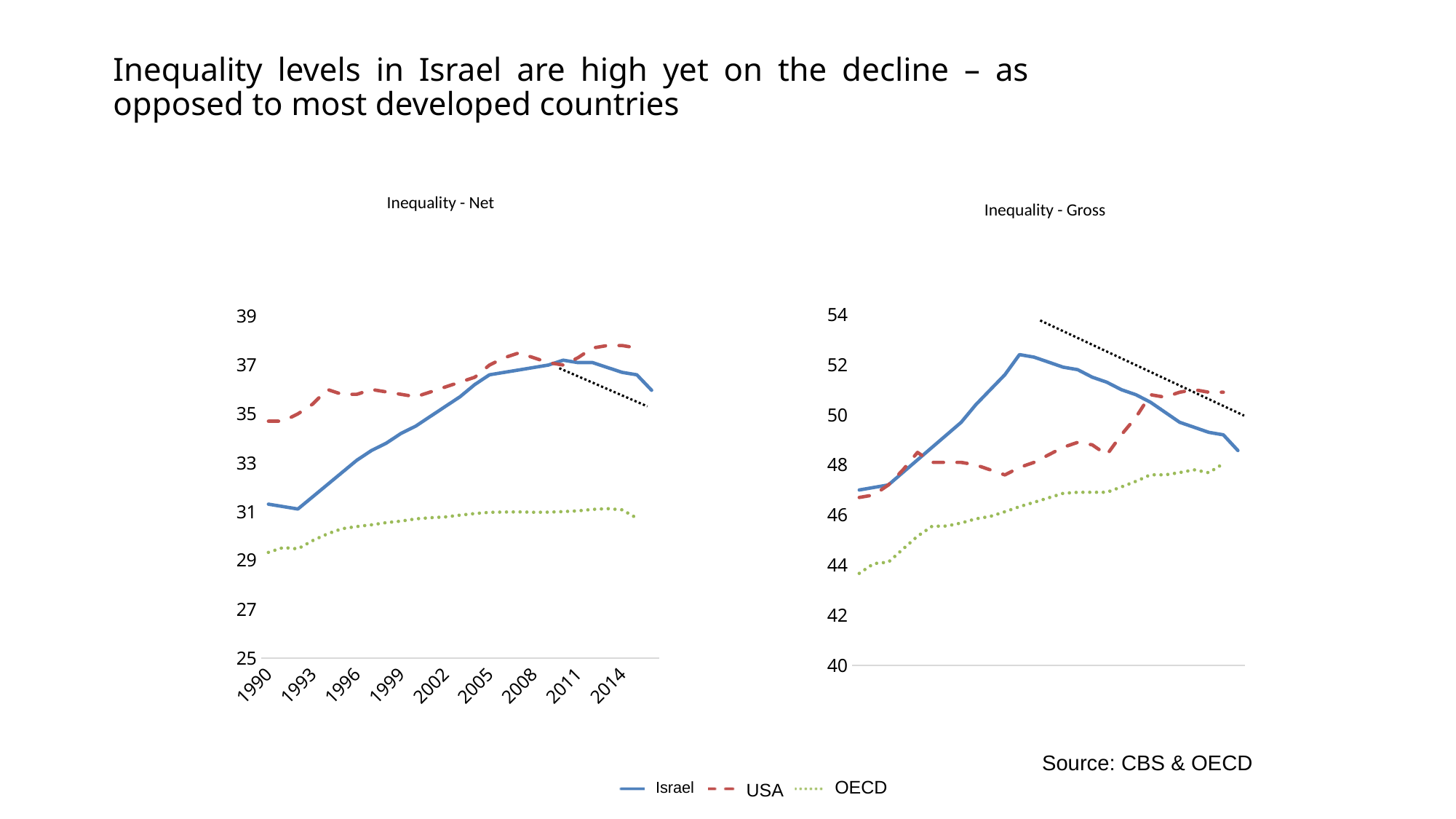
In the "Inequality - Net" chart, which is higher in 2014, USA or OECD? USA In the "Inequality - Net" chart, is the value for USA in 1990 greater or less than 35? less In the "Inequality - Net" chart, is the value for OECD in 1990 greater or less than 29? greater How many series does the legend list? 3 In the "Inequality - Net" chart, does the Israel line rise or fall from 1993 to 2005? rise In the "Inequality - Gross" chart, is the highest value reached by Israel greater or less than 52? greater What is the title of the chart on the right? Inequality - Gross In the "Inequality - Net" chart, which is higher in 1990, Israel or USA? USA In the "Inequality - Gross" chart, which series has the lowest values throughout? OECD What kind of chart is the "Inequality - Net" chart? line chart